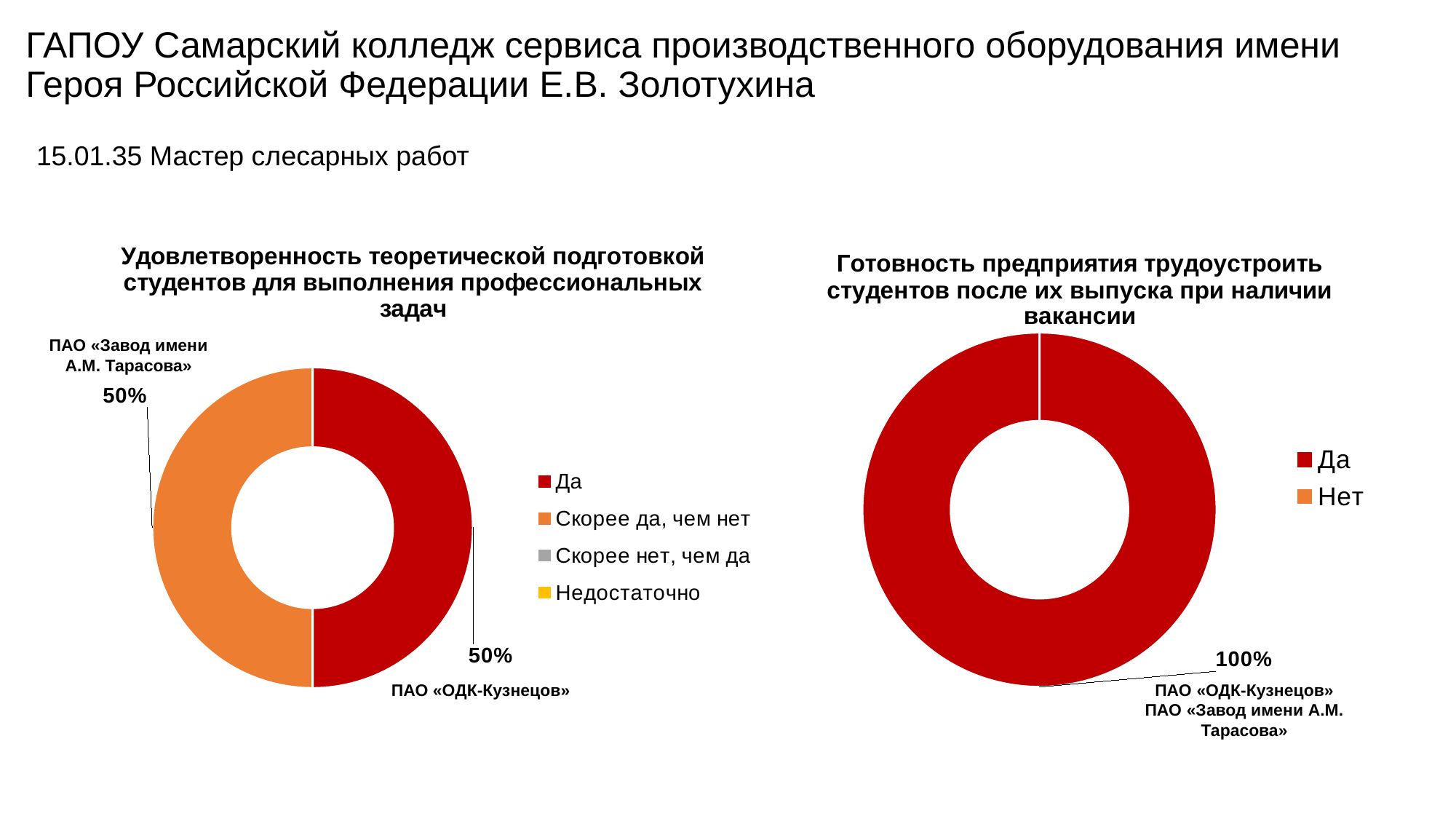
In the right chart, which legend entry has no visible slice? Нет In the chart 'Удовлетворенность теоретической подготовкой студентов для выполнения профессиональных задач', what share is labelled for the 'Скорее да, чем нет' slice? 50% What is the difference between the 'Да' and 'Скорее да, чем нет' shares in the left chart? 0% What colour represents 'Да' in the right chart's legend? Red What kind of chart is the left chart on the slide? Doughnut (pie) chart How many entries does the legend of the right chart list? 2 In the left chart, which enterprise is attached to the 'Да' slice? ПАО «ОДК-Кузнецов» In the left chart, which enterprise is attached to the 'Скорее да, чем нет' slice? ПАО «Завод имени А.М. Тарасова» How many entries does the legend of the left chart list? 4 How many charts are shown on the slide? 2 In the chart 'Готовность предприятия трудоустроить студентов после их выпуска при наличии вакансии', what share is labelled for 'Да'? 100% In the chart 'Удовлетворенность теоретической подготовкой студентов для выполнения профессиональных задач', what share is labelled for the 'Да' slice? 50%